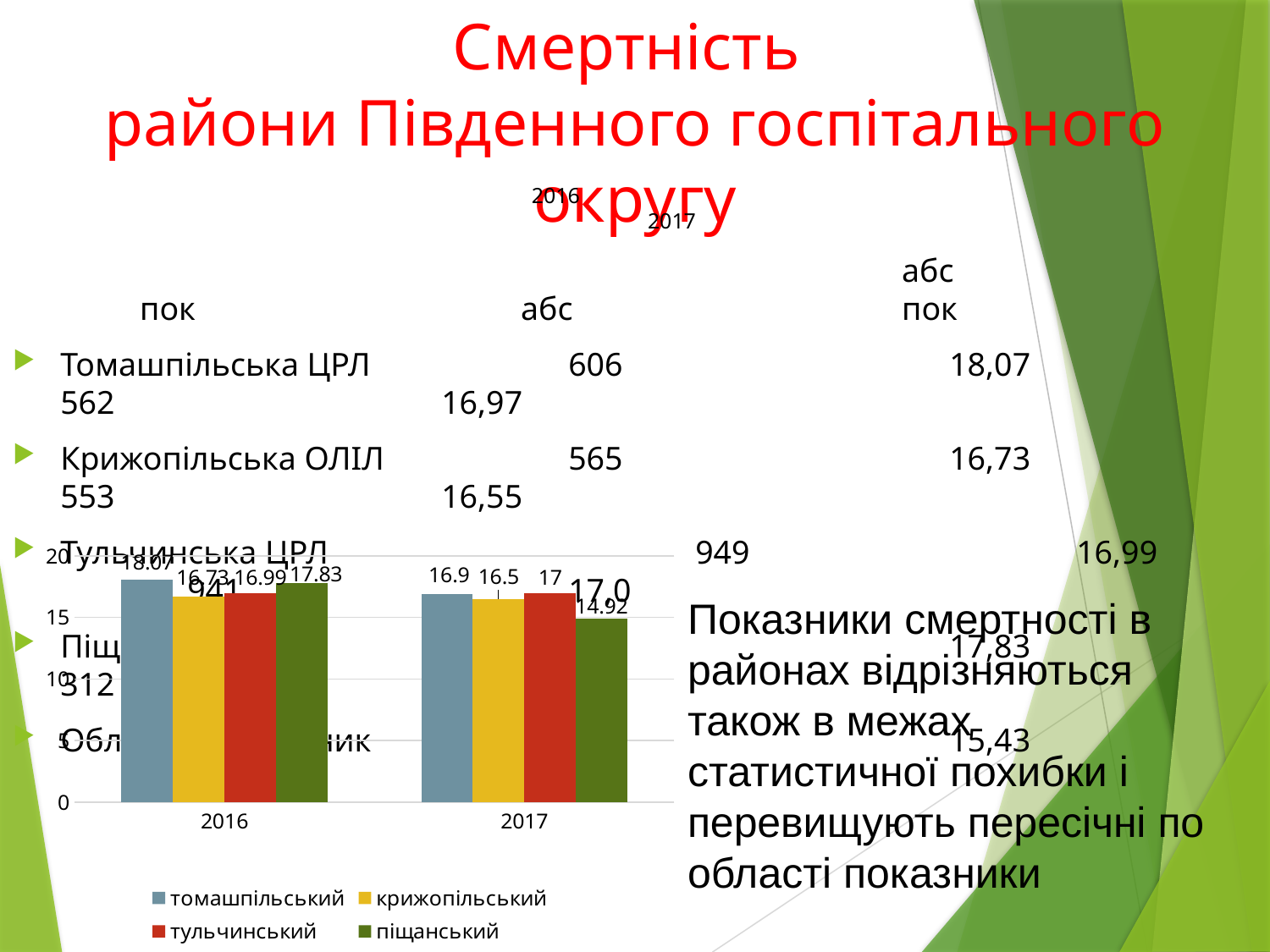
Does the value for томашпільський rise or fall from 2016 to 2017? fall How many series does the legend list? 4 Is the value for піщанський in 2017 greater or less than 15? less What is the value for крижопільський in 2016? 16.73 For крижопільський, which year has the larger value, 2016 or 2017? 2016 How many year categories are shown on the x axis? 2 Which series has the lowest value in 2017? піщанський What is the difference between the піщанський values for 2016 and 2017? 2.91 What kind of chart is shown on the slide? bar chart What is the value for томашпільський in 2016? 18.07 Which series has the highest value in 2016? томашпільський What is the value for піщанський in 2017? 14.92